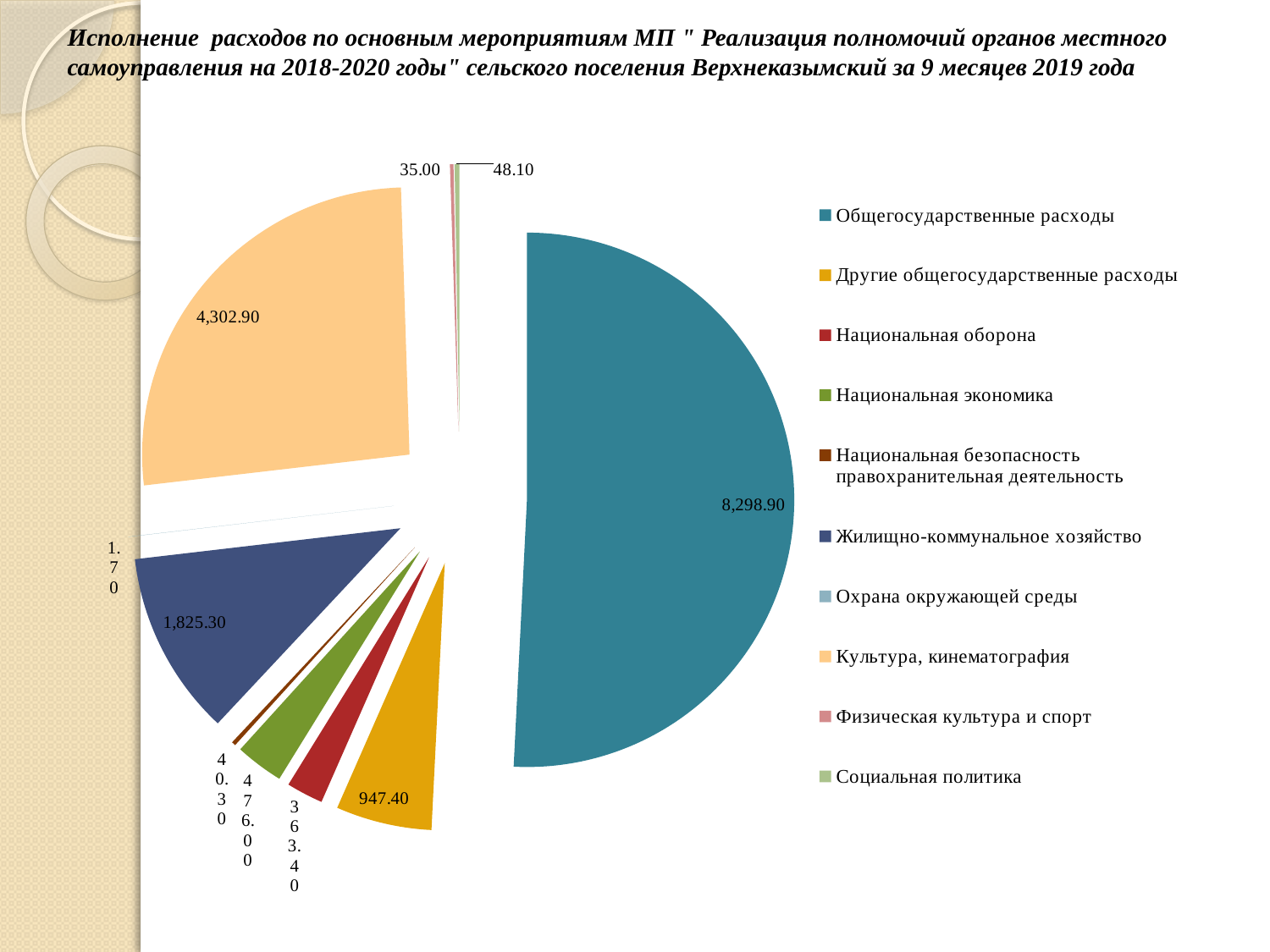
Which category has the largest slice of the pie? Общегосударственные расходы What is the value for Другие общегосударственные расходы? 947.40 What is the value for Физическая культура и спорт? 35.00 Which is larger, Культура, кинематография or Жилищно-коммунальное хозяйство? Культура, кинематография What is the value for Общегосударственные расходы? 8,298.90 What colour is the slice for Общегосударственные расходы? teal How many categories does the legend of the pie chart list? 10 What kind of chart is shown on the slide? pie chart What is the value for Жилищно-коммунальное хозяйство? 1,825.30 What is the value for Культура, кинематография? 4,302.90 What is the value for Социальная политика? 48.10 What is the difference between Общегосударственные расходы and Культура, кинематография? 3,996.00